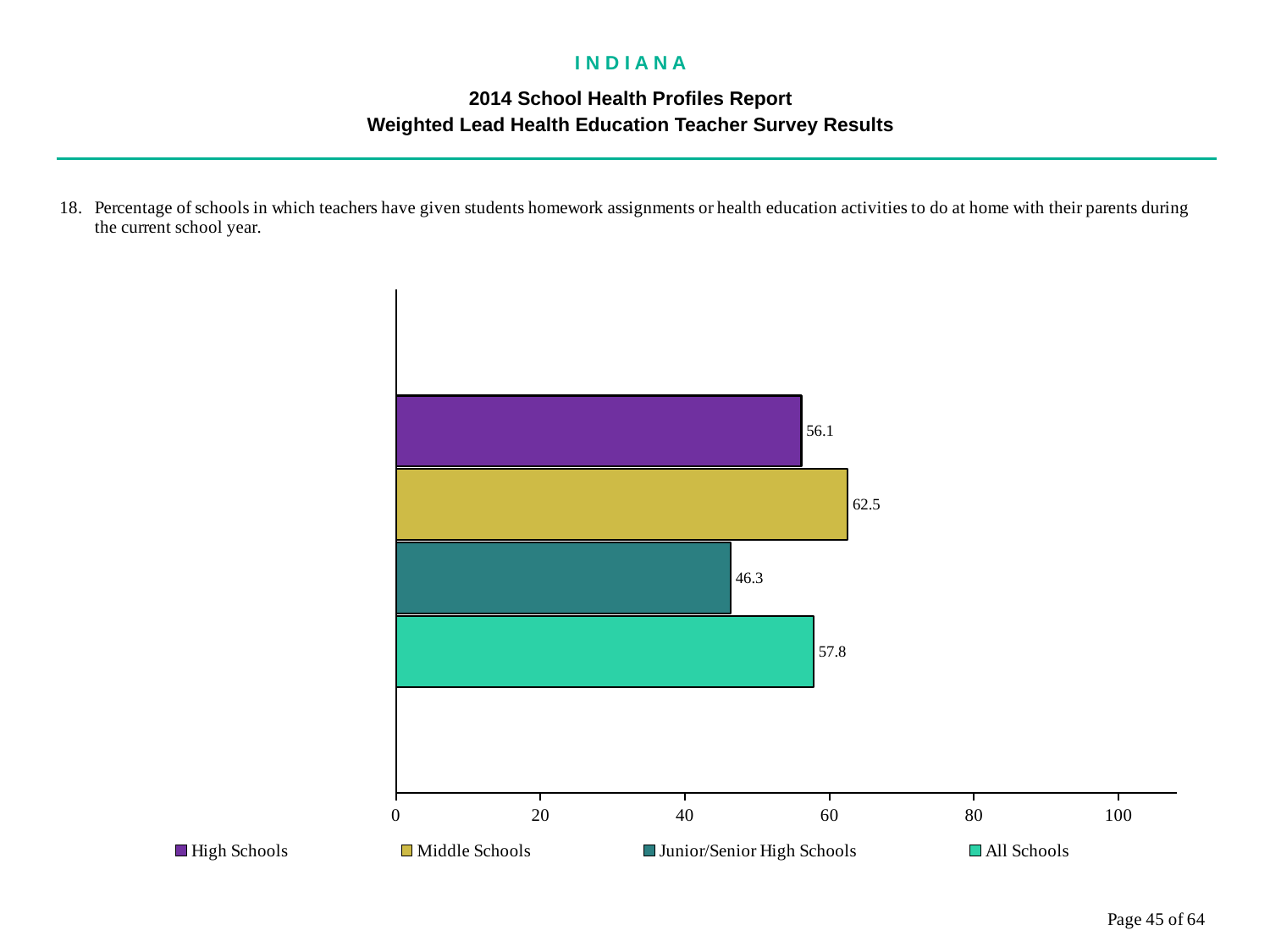
Which school type has the lowest value? Junior/Senior High Schools What is the value for All Schools? 57.8 What is the difference between the All Schools value and the High Schools value? 1.7 How many series does the legend list? 4 What is the difference between the Middle Schools value and the Junior/Senior High Schools value? 16.2 Which is larger, the value for High Schools or the value for Junior/Senior High Schools? High Schools What is the value for Middle Schools? 62.5 What kind of chart is shown on the slide? bar chart Which school type has the highest value? Middle Schools What is the value for High Schools? 56.1 Is the value for Middle Schools greater or less than 60? greater What is the value for Junior/Senior High Schools? 46.3